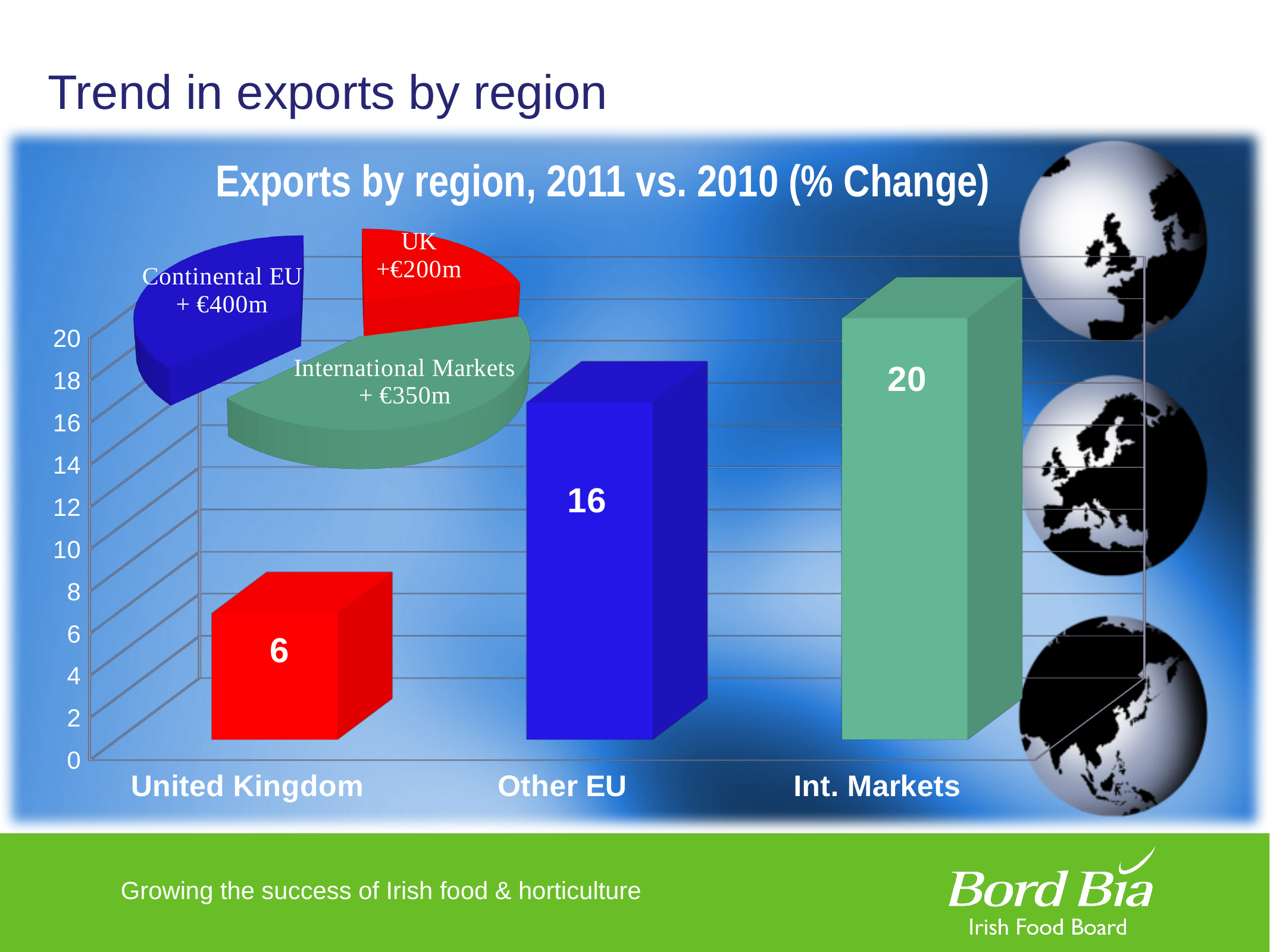
In the pie chart, what amount is shown for Continental EU? + €400m In the bar chart, do the values rise or fall from United Kingdom to Int. Markets? rise What is the title of the bar chart? Exports by region, 2011 vs. 2010 (% Change) In the bar chart, which region has the highest % change? Int. Markets In the bar chart, what is the value for United Kingdom? 6 In the bar chart, what is the difference between the values for Int. Markets and United Kingdom? 14 How many bars are shown in the bar chart? 3 In the bar chart, which region has the lowest % change? United Kingdom In the bar chart, what is the value for Int. Markets? 20 In the bar chart, which is larger, the value for Other EU or the value for United Kingdom? Other EU In the bar chart, what is the value for Other EU? 16 What kind of chart shows the values 6, 16 and 20? bar chart